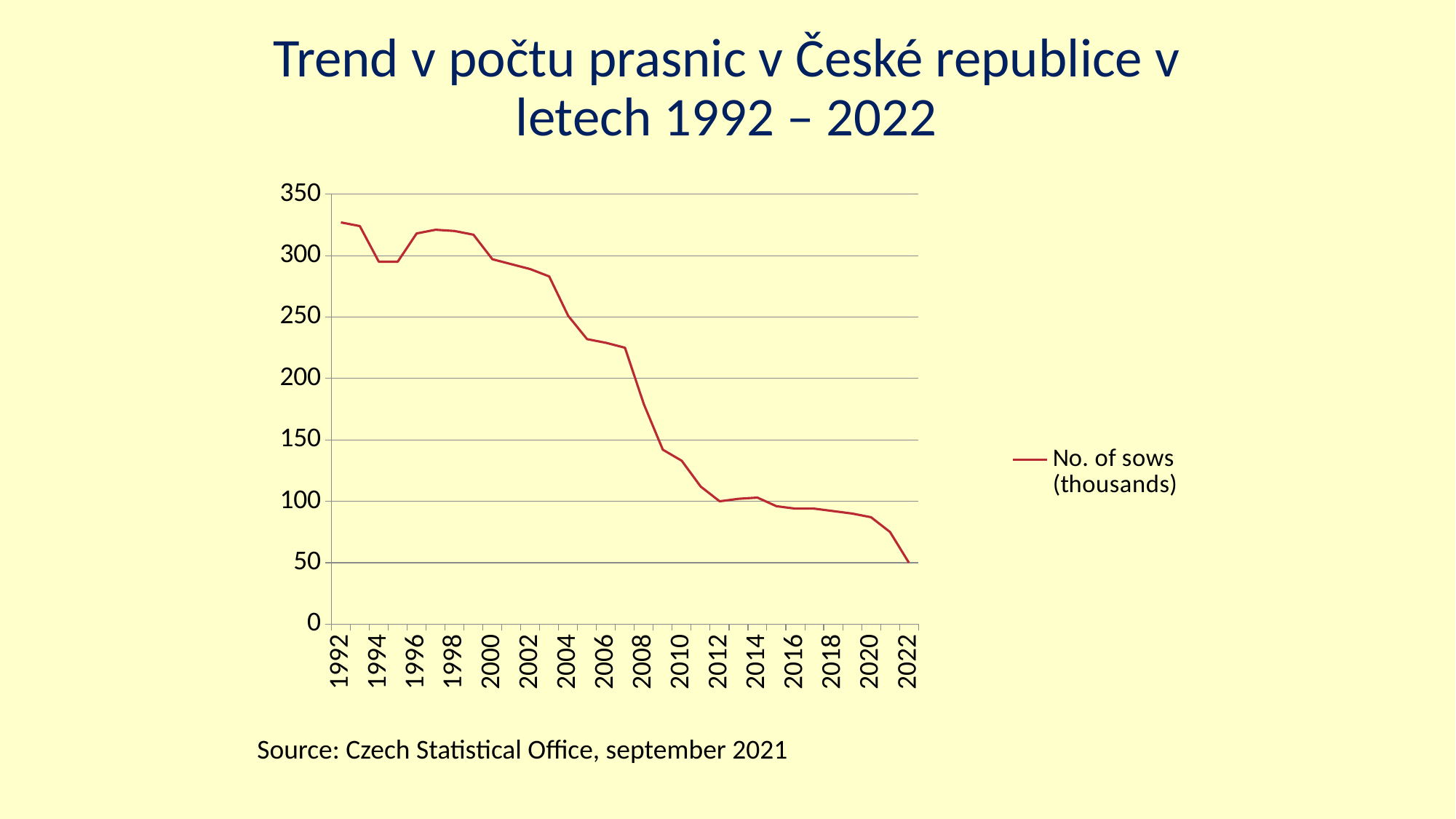
Is the value for 2010 greater or less than 150? less How many year labels are shown on the x axis? 16 Which year has the larger value, 2000 or 2010? 2000 Which year has the lowest number of sows? 2022 Do the values rise or fall from 1992 to 2022? fall How many series does the legend list? 1 Is the value for 2005 greater or less than 250? less Is the value for 1992 greater or less than 300? greater What kind of chart is shown on the slide? line chart What is the legend entry for the plotted series? No. of sows (thousands)